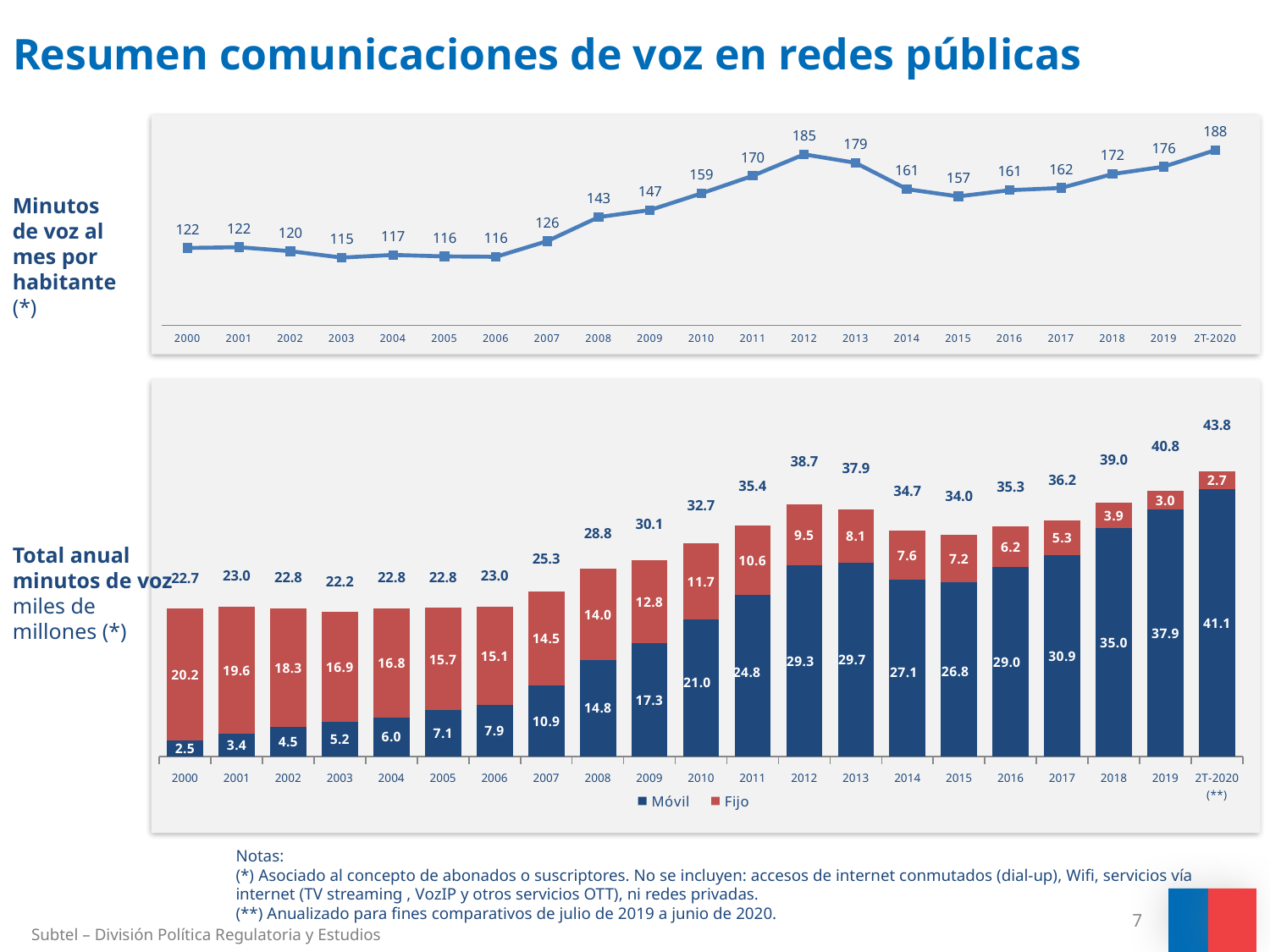
In the bottom chart (Total anual minutos de voz), does the Fijo series rise or fall from 2000 to 2T-2020? Fall In the top chart (Minutos de voz al mes por habitante), what is the value for 2012? 185 In the top chart (Minutos de voz al mes por habitante), which year has the lowest value? 2003 How many series does the legend of the bottom chart (Total anual minutos de voz) list? 2 In the top chart (Minutos de voz al mes por habitante), what is the difference between the values for 2012 and 2013? 6 In the bottom chart (Total anual minutos de voz), is the Móvil value for 2012 or for 2015 larger? 2012 In the bottom chart (Total anual minutos de voz), what is the Fijo value for 2000? 20.2 In the bottom chart (Total anual minutos de voz), which year has the highest Fijo value? 2000 In the top chart (Minutos de voz al mes por habitante), which year or period has the highest value? 2T-2020 In the bottom chart (Total anual minutos de voz), what is the Móvil value for 2010? 21.0 In the bottom chart (Total anual minutos de voz), what is the total of the stacked bar for 2T-2020? 43.8 What kind of chart is the top chart (Minutos de voz al mes por habitante)? Line chart